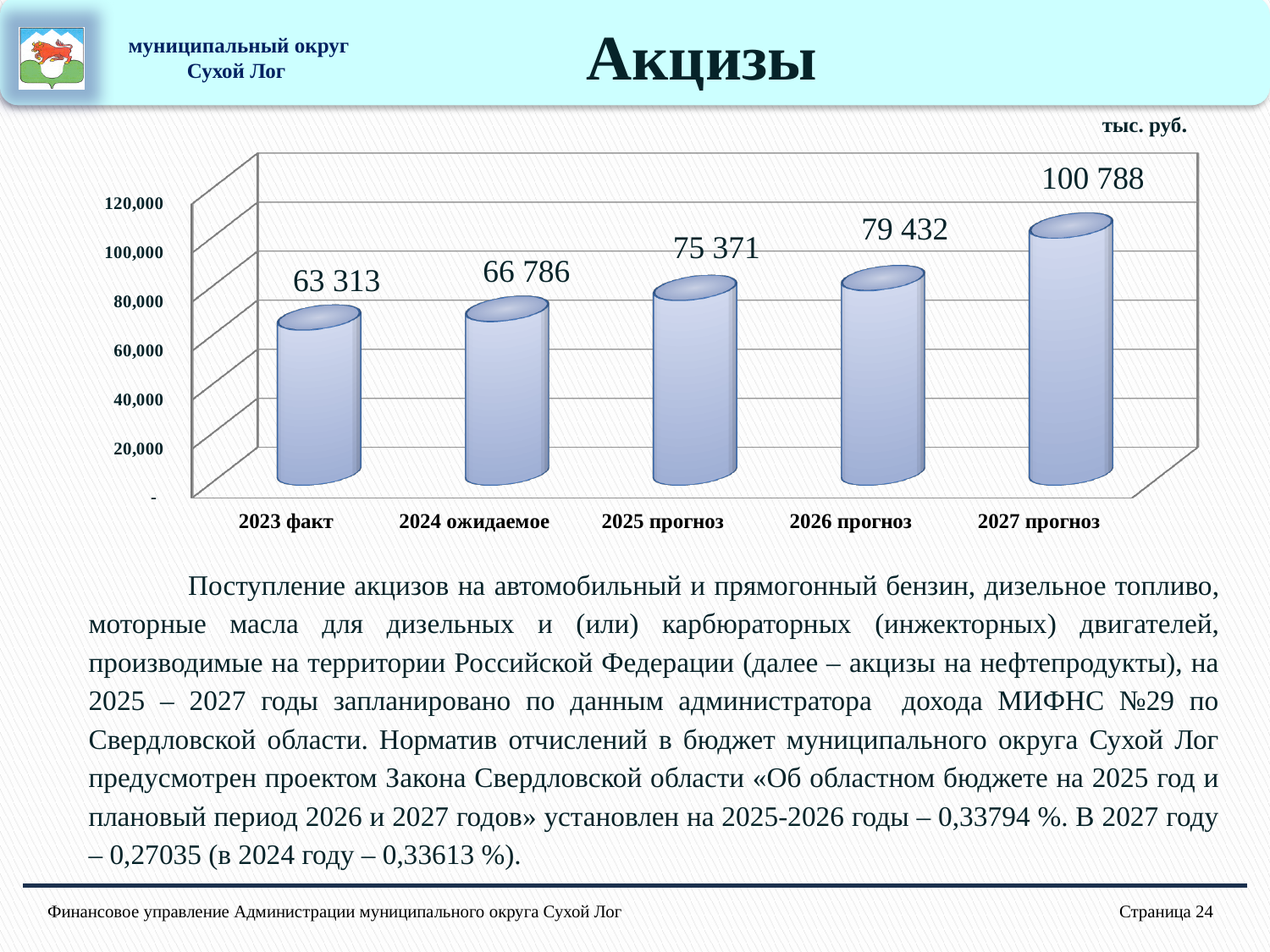
How many categories are shown on the x axis? 5 Which is larger, the value for 2025 прогноз or the value for 2024 ожидаемое? 2025 прогноз Which category has the highest value? 2027 прогноз Do the values rise or fall from 2023 факт to 2027 прогноз? rise Which category has the lowest value? 2023 факт What is the difference between the values for 2027 прогноз and 2026 прогноз? 21 356 What is the value for 2025 прогноз? 75 371 What is the difference between the values for 2024 ожидаемое and 2023 факт? 3 473 Is the value for 2026 прогноз greater or less than 100,000? less What kind of chart is shown on the slide? bar chart What is the value for 2027 прогноз? 100 788 What is the value for 2023 факт? 63 313